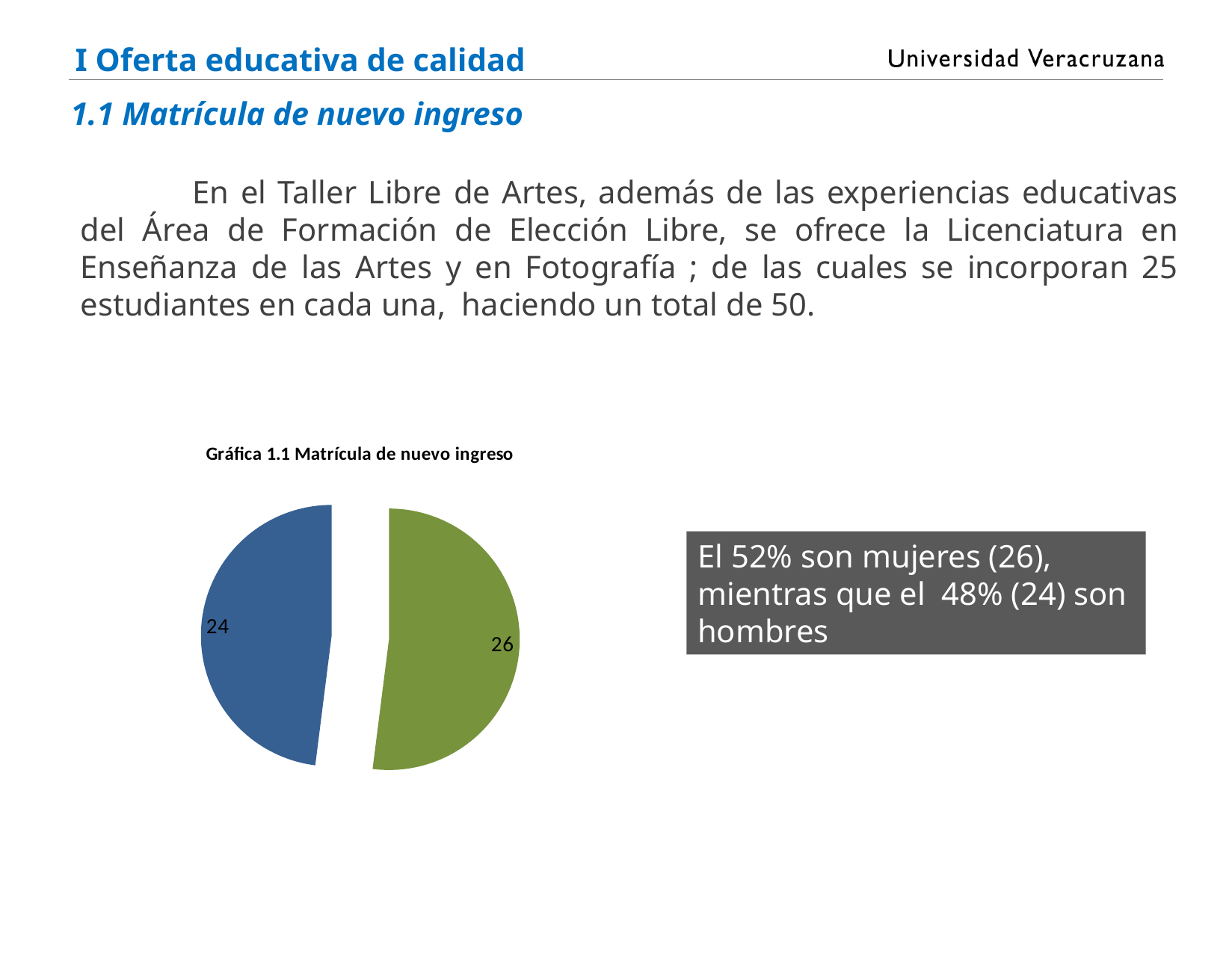
Which slice of the pie chart is the largest? the green slice (26) What share of the pie does the green slice (26) represent? 52% What value is labelled on the blue slice of the pie chart? 24 What is the difference between the values of the green slice and the blue slice? 2 How many slices does the pie chart have? 2 Is the green slice or the blue slice of the pie chart larger? the green slice What is the title of the chart on the slide? Gráfica 1.1 Matrícula de nuevo ingreso What share of the pie does the blue slice (24) represent? 48% What value is labelled on the green slice of the pie chart? 26 Which slice of the pie chart is the smallest? the blue slice (24) What is the total of the two slices in the pie chart? 50 What kind of chart is shown on the slide? pie chart